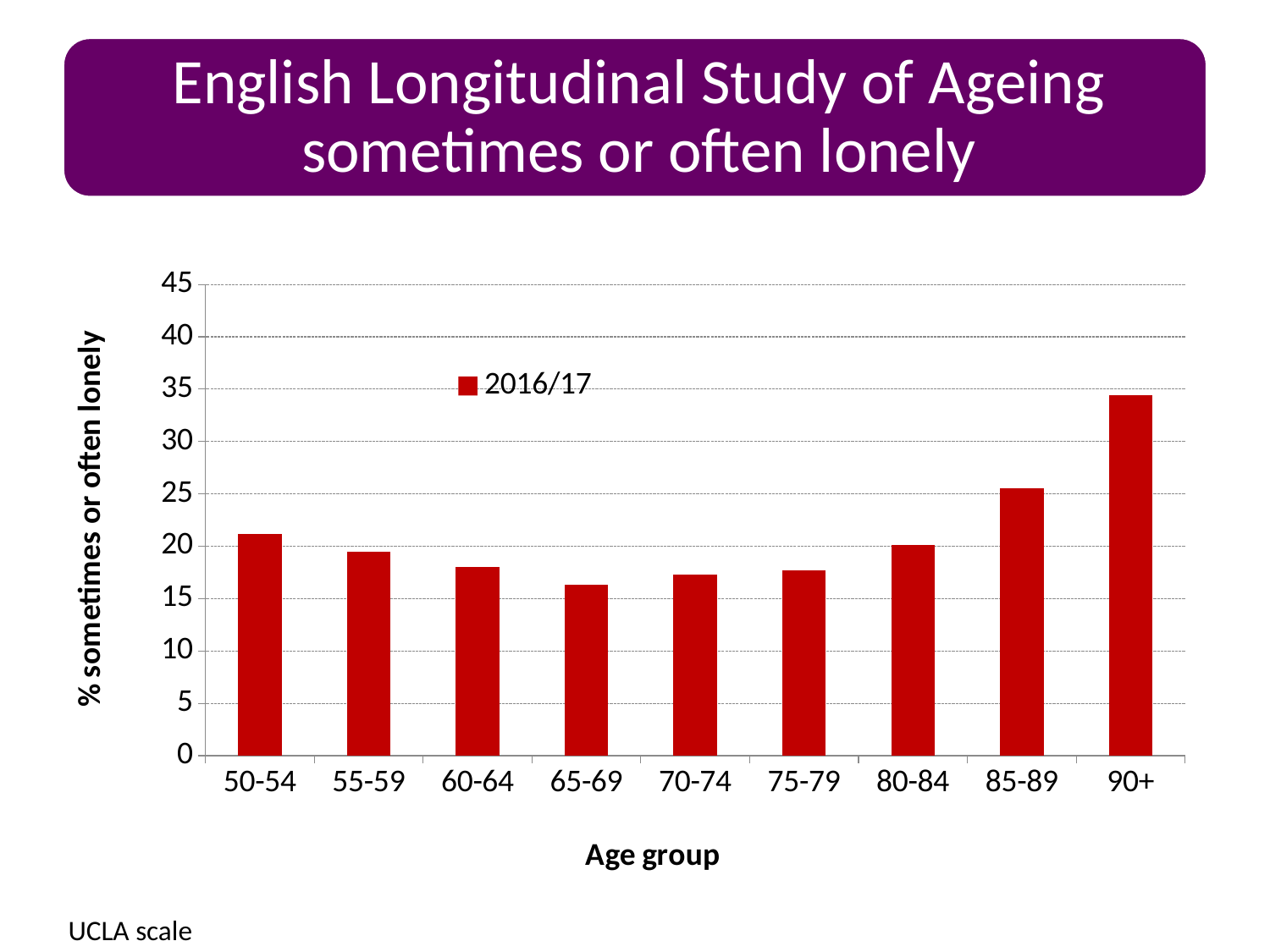
Which has a higher value, the 50-54 age group or the 60-64 age group? 50-54 How many age groups are shown on the x axis? 9 Is the value for the 65-69 age group greater or less than 20? less What kind of chart is shown on the slide? bar chart Is the value for the 90+ age group greater or less than 30? greater What is the label of the x axis? Age group Is the value for the 85-89 age group greater or less than 20? greater Which age group has the lowest percentage of people sometimes or often lonely? 65-69 Which age group has the highest percentage of people sometimes or often lonely? 90+ Which has a higher value, the 85-89 age group or the 80-84 age group? 85-89 How many series does the legend list? 1 What series name is shown in the legend? 2016/17